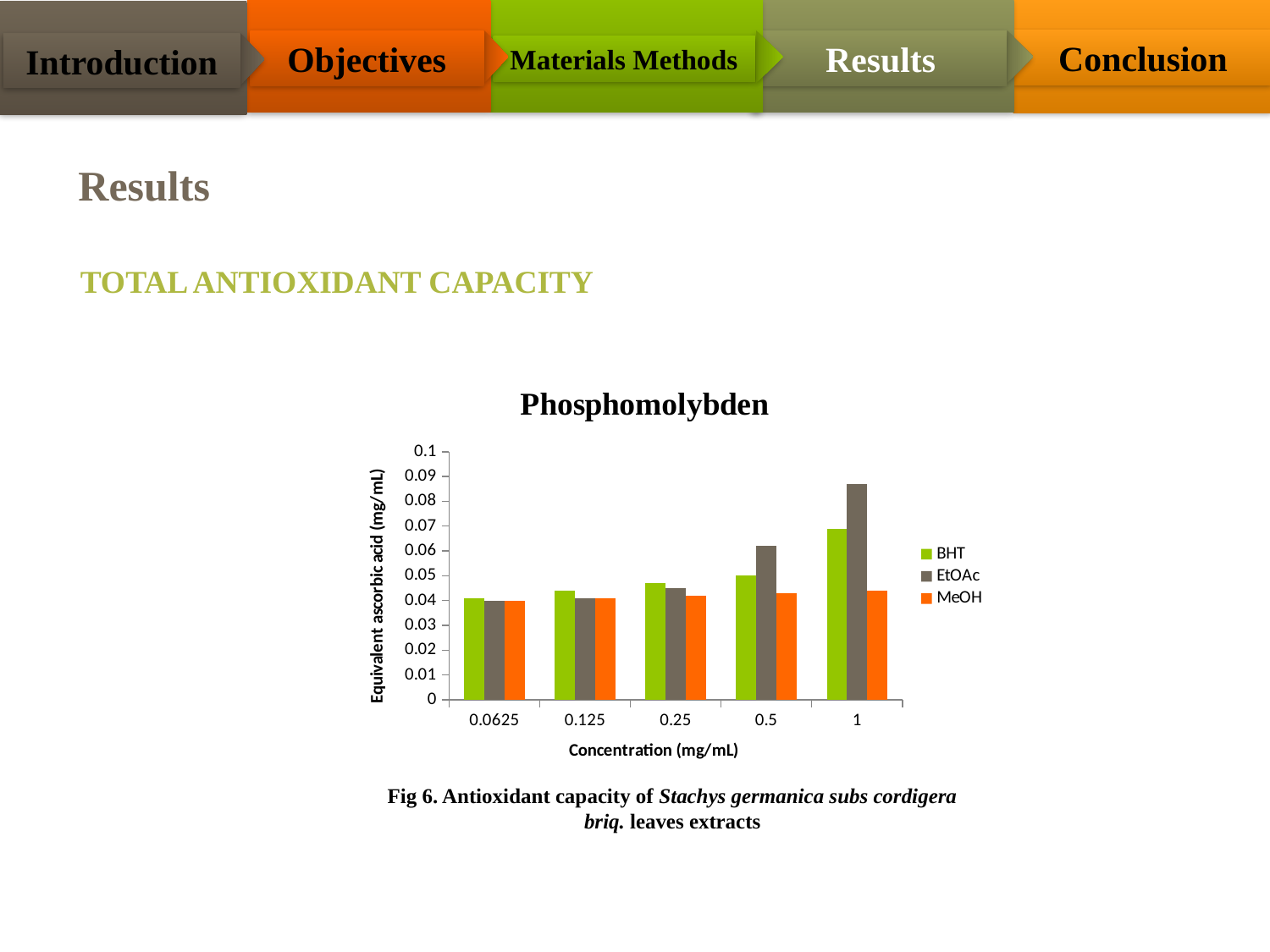
Which series has the highest bar at a concentration of 1 mg/mL? EtOAc What is the title of the chart? Phosphomolybden Is the value for EtOAc at 1 mg/mL greater or less than 0.08? greater At 0.5 mg/mL, which is larger, the EtOAc value or the MeOH value? EtOAc Is the value for BHT at 1 mg/mL greater or less than 0.06? greater How many concentration categories are shown on the x axis of the Phosphomolybden chart? 5 Is the value for MeOH at 1 mg/mL greater or less than 0.05? less How many series does the legend of the Phosphomolybden chart list? 3 What kind of chart is shown on the slide? bar chart What is the label of the y axis of the chart? Equivalent ascorbic acid (mg/mL) Which series has the lowest bar at a concentration of 1 mg/mL? MeOH Do the EtOAc values rise or fall as concentration increases along the x axis? rise